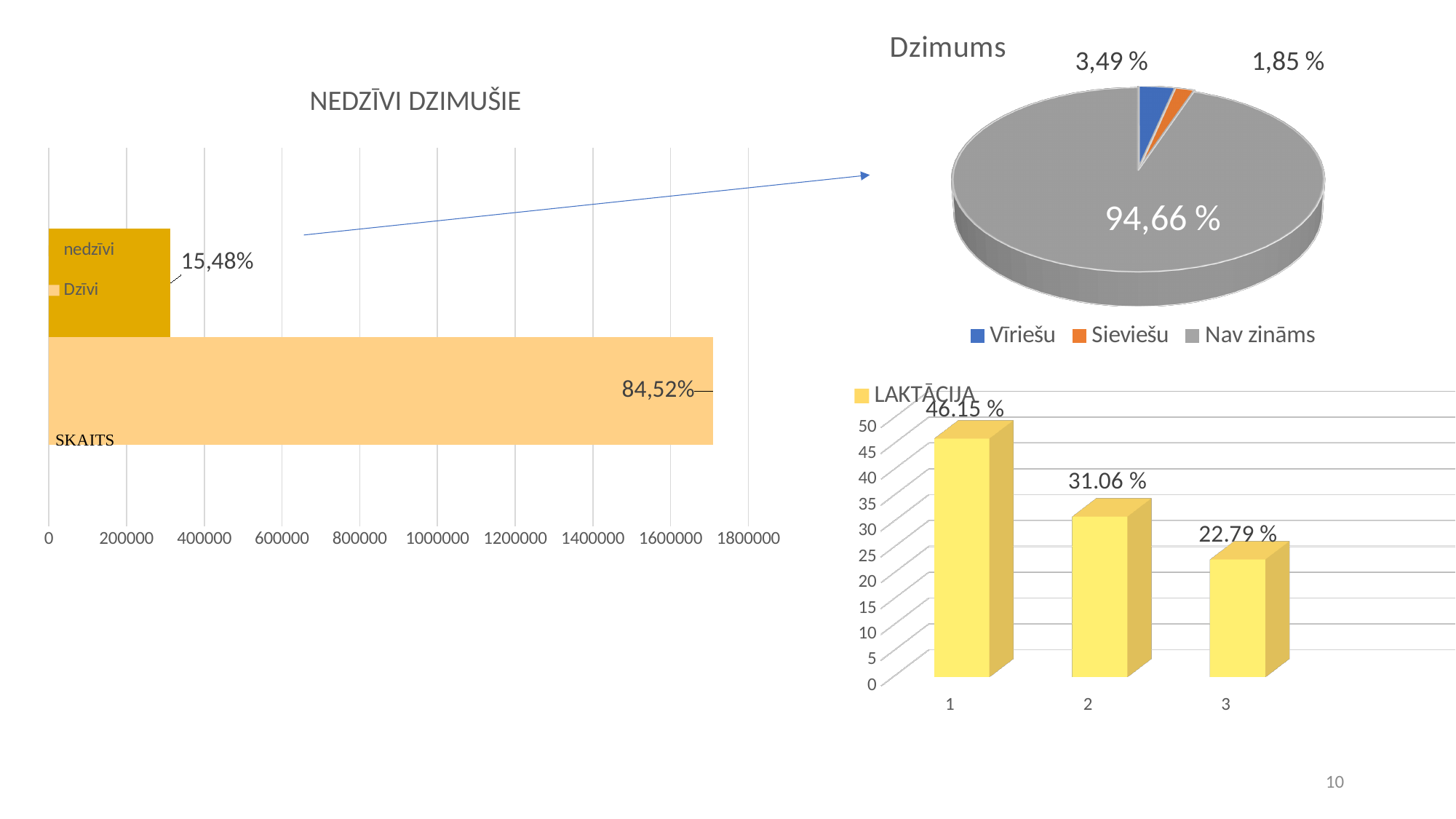
What kind of chart is the NEDZĪVI DZIMUŠIE chart? bar chart In the Dzimums pie chart, which category has the smallest slice? Sieviešu In the LAKTĀCIJA chart, what is the value for category 2? 31.06 % In the NEDZĪVI DZIMUŠIE chart, is the value for the nedzīvi bar greater or less than 400000? less In the NEDZĪVI DZIMUŠIE chart, is the value for the Dzīvi bar greater or less than 1600000? greater In the Dzimums pie chart, what share is labelled for Nav zināms? 94,66 % In the Dzimums pie chart, what share is labelled for Vīriešu? 3,49 % In the LAKTĀCIJA chart, do the values rise or fall from category 1 to category 3? fall In the LAKTĀCIJA chart, what is the difference between the values for category 1 and category 2? 15.09 % In the NEDZĪVI DZIMUŠIE chart, what percentage label is shown for the nedzīvi bar? 15,48% In the NEDZĪVI DZIMUŠIE chart, what percentage label is shown for the Dzīvi bar? 84,52% How many entries does the legend of the Dzimums pie chart list? 3